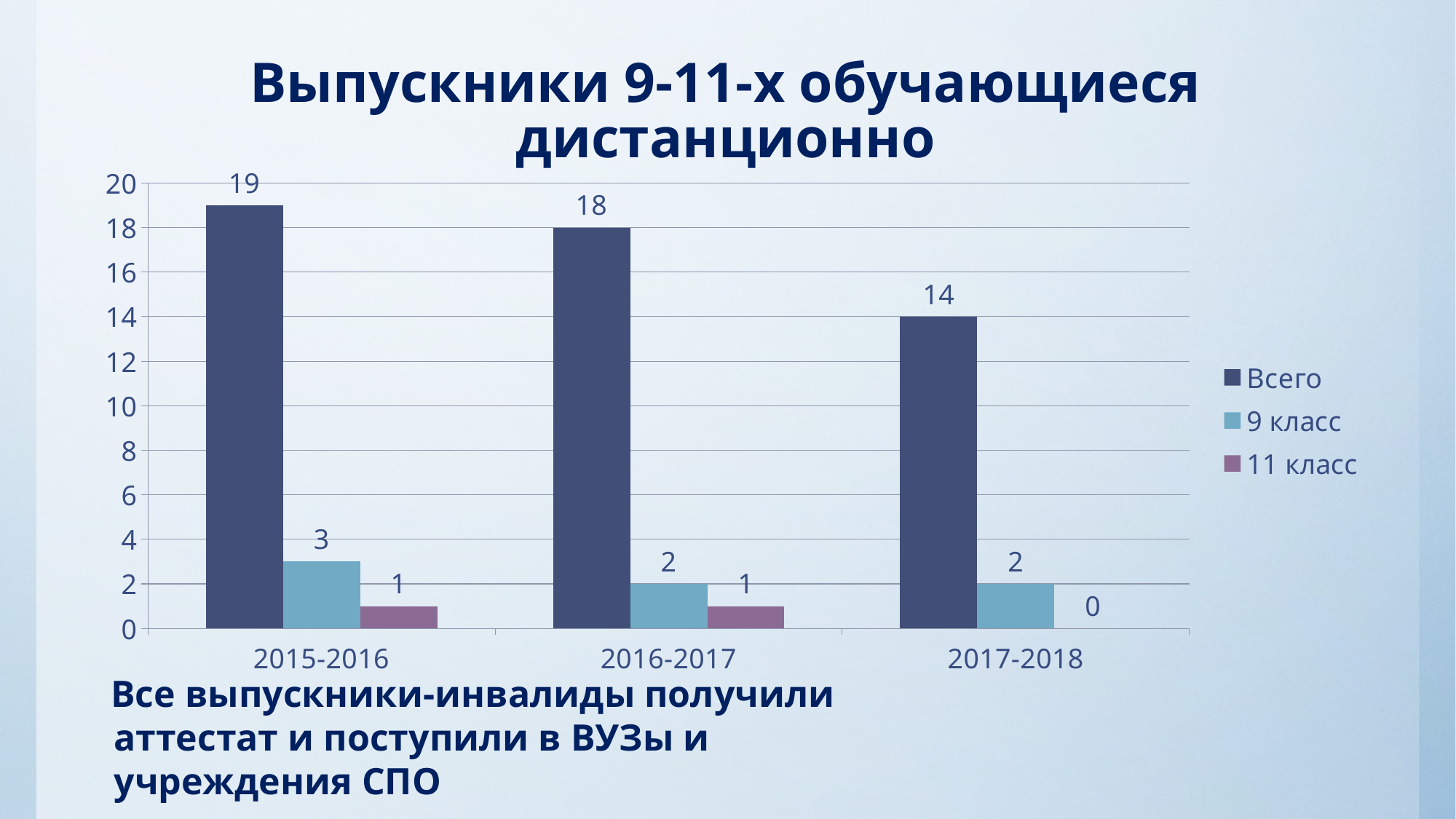
Does the Всего value rise or fall from 2015-2016 to 2017-2018? Fall What is the value of Всего for 2015-2016? 19 Which is larger: 9 класс in 2015-2016 or 9 класс in 2017-2018? 9 класс in 2015-2016 What is the value of 11 класс for 2017-2018? 0 What kind of chart is shown on the slide? Bar chart What is the value of Всего for 2017-2018? 14 How many year categories are shown on the x axis? 3 In which year is the Всего value lowest? 2017-2018 What is the value of 9 класс for 2016-2017? 2 How many series does the legend list? 3 What is the difference between the Всего values for 2015-2016 and 2017-2018? 5 In which year is the Всего value highest? 2015-2016